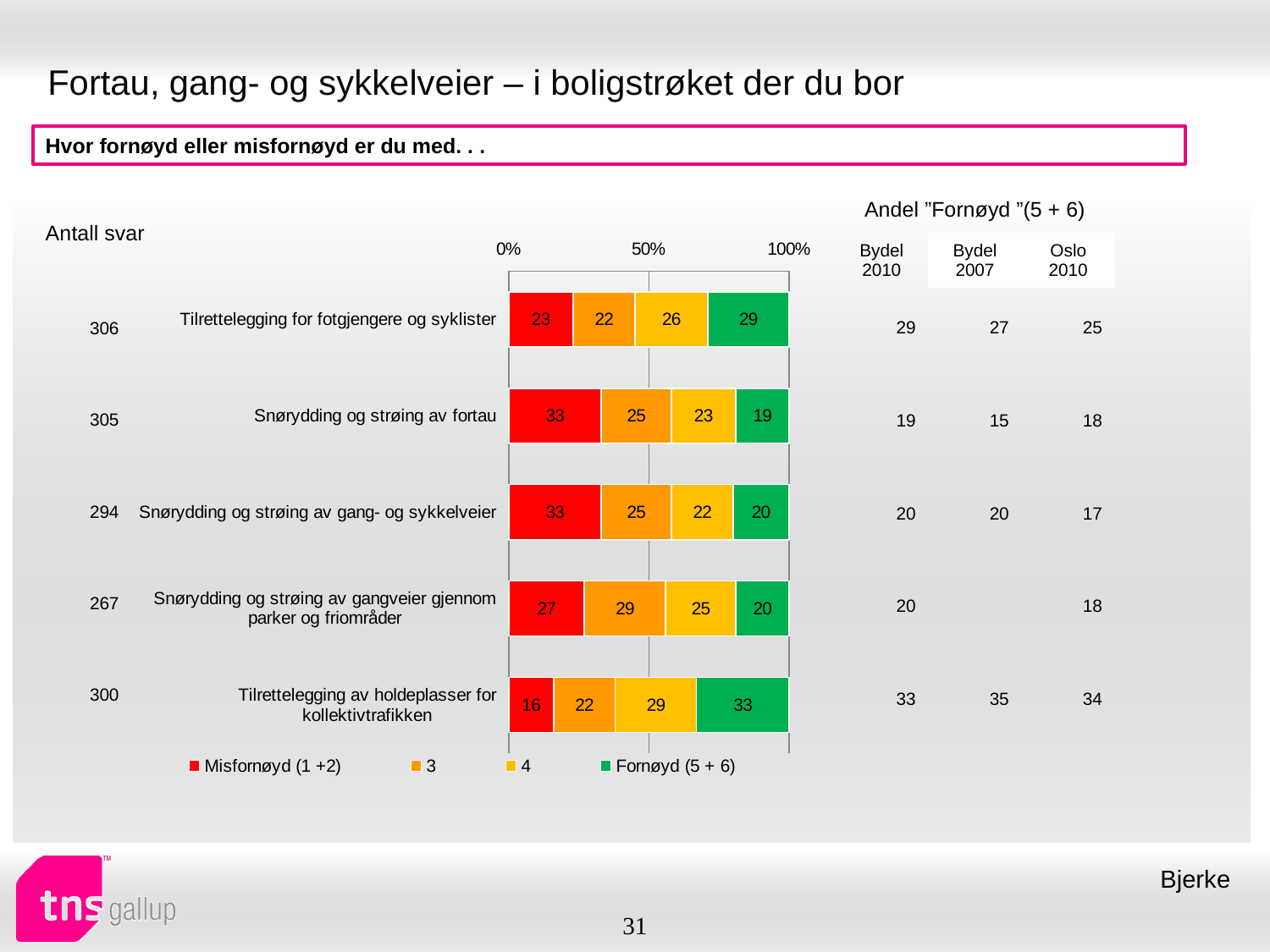
Which has the larger "Misfornøyd (1 +2)" value: "Snørydding og strøing av fortau" or "Snørydding og strøing av gangveier gjennom parker og friområder"? Snørydding og strøing av fortau How many categories are shown in the bar chart? 5 How many series does the legend list? 4 What is the total of the stacked bar for "Snørydding og strøing av fortau"? 100 Which category has the lowest "Misfornøyd (1 +2)" value? Tilrettelegging av holdeplasser for kollektivtrafikken What colour represents the "Fornøyd (5 + 6)" series in the chart? Green What is the value of the "4" segment for "Tilrettelegging for fotgjengere og syklister"? 26 Which category has the highest "Fornøyd (5 + 6)" value? Tilrettelegging av holdeplasser for kollektivtrafikken What is the value of the "Misfornøyd (1 +2)" segment for "Snørydding og strøing av fortau"? 33 What is the value of the "Fornøyd (5 + 6)" segment for "Tilrettelegging av holdeplasser for kollektivtrafikken"? 33 What is the difference between the "Fornøyd (5 + 6)" values for "Tilrettelegging for fotgjengere og syklister" and "Snørydding og strøing av fortau"? 10 What kind of chart is shown on the slide? Stacked bar chart